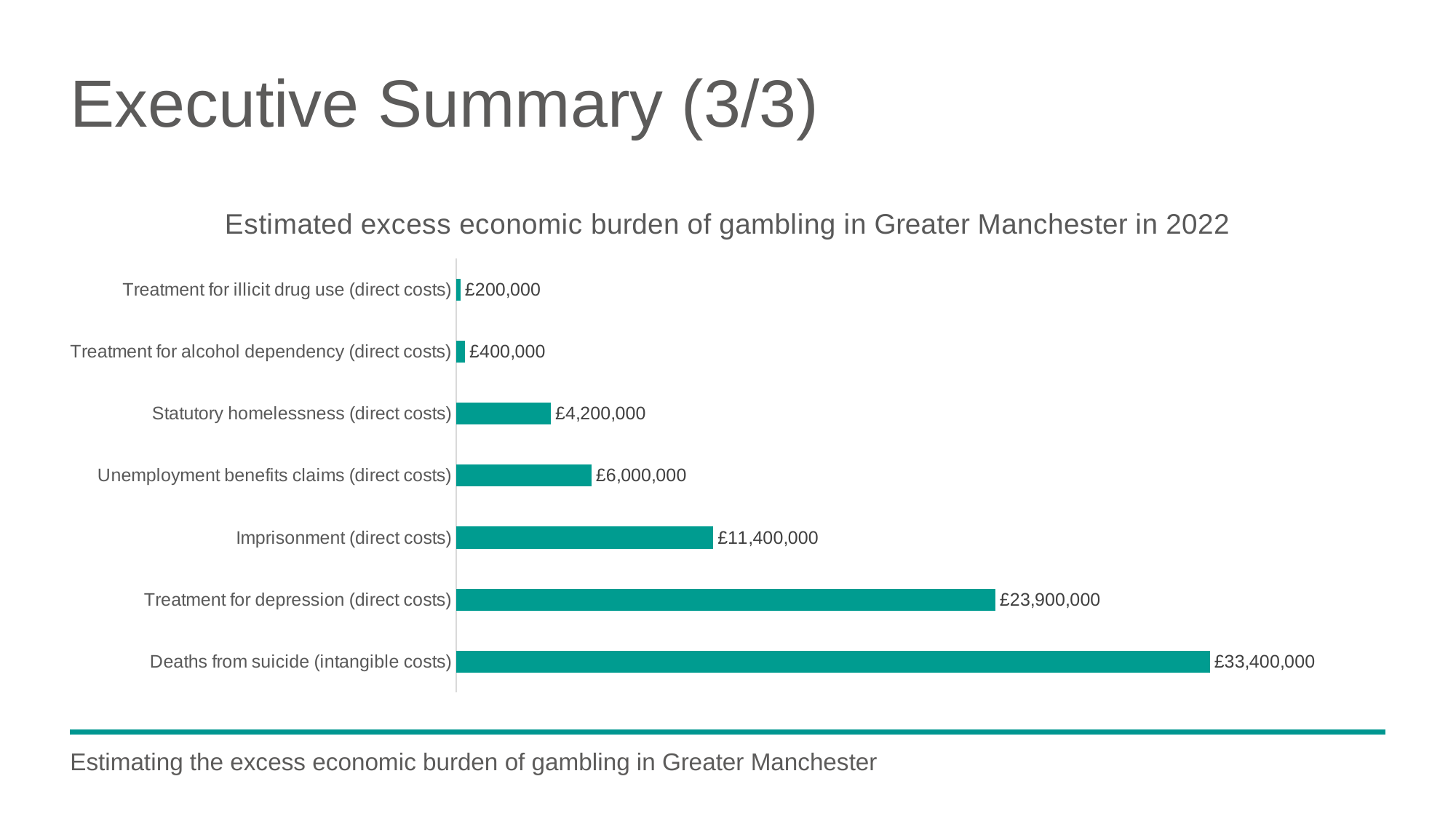
What is the difference between the cost for Unemployment benefits claims (direct costs) and Statutory homelessness (direct costs)? £1,800,000 What is the difference between the cost for Deaths from suicide (intangible costs) and Treatment for depression (direct costs)? £9,500,000 What is the estimated cost for Treatment for depression (direct costs)? £23,900,000 What is the estimated cost for Statutory homelessness (direct costs)? £4,200,000 Which category has the lowest estimated cost? Treatment for illicit drug use (direct costs) How many categories are shown in the chart? 7 What is the estimated cost for Imprisonment (direct costs)? £11,400,000 What kind of chart is shown on the slide? Bar chart What is the estimated cost for Deaths from suicide (intangible costs)? £33,400,000 What is the title of the chart? Estimated excess economic burden of gambling in Greater Manchester in 2022 Which is larger, the cost for Imprisonment (direct costs) or Unemployment benefits claims (direct costs)? Imprisonment (direct costs) Which category has the highest estimated cost? Deaths from suicide (intangible costs)